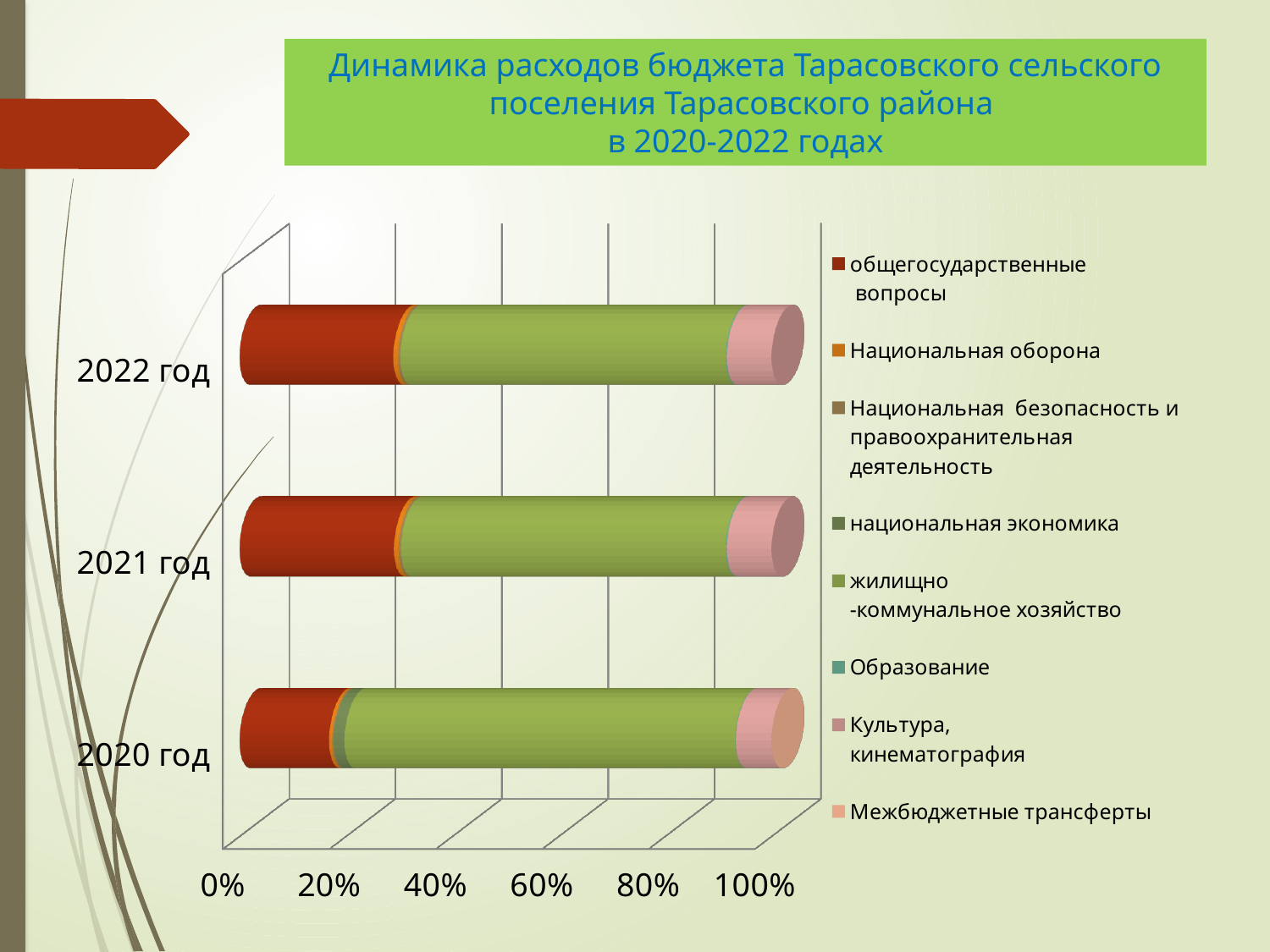
In 2021 год, which is larger: the share of жилищно-коммунальное хозяйство or the share of общегосударственные вопросы? жилищно-коммунальное хозяйство Is the share of жилищно-коммунальное хозяйство in 2021 год greater or less than 40%? greater How many series does the chart legend list? 8 How many years (categories) are plotted on the chart? 3 What kind of chart is shown on the slide? bar chart Which series takes up the largest share of the bar for 2020 год? жилищно-коммунальное хозяйство What is the title of the chart on the slide? Динамика расходов бюджета Тарасовского сельского поселения Тарасовского района в 2020-2022 годах In 2022 год, which is larger: the share of общегосударственные вопросы or the share of Культура, кинематография? общегосударственные вопросы Which series takes up the largest share of the bar for 2022 год? жилищно-коммунальное хозяйство Is the share of общегосударственные вопросы in 2022 год greater or less than 40%? less Which legend entry is shown in dark red? общегосударственные вопросы Is the share of общегосударственные вопросы in 2020 год greater or less than 20%? less